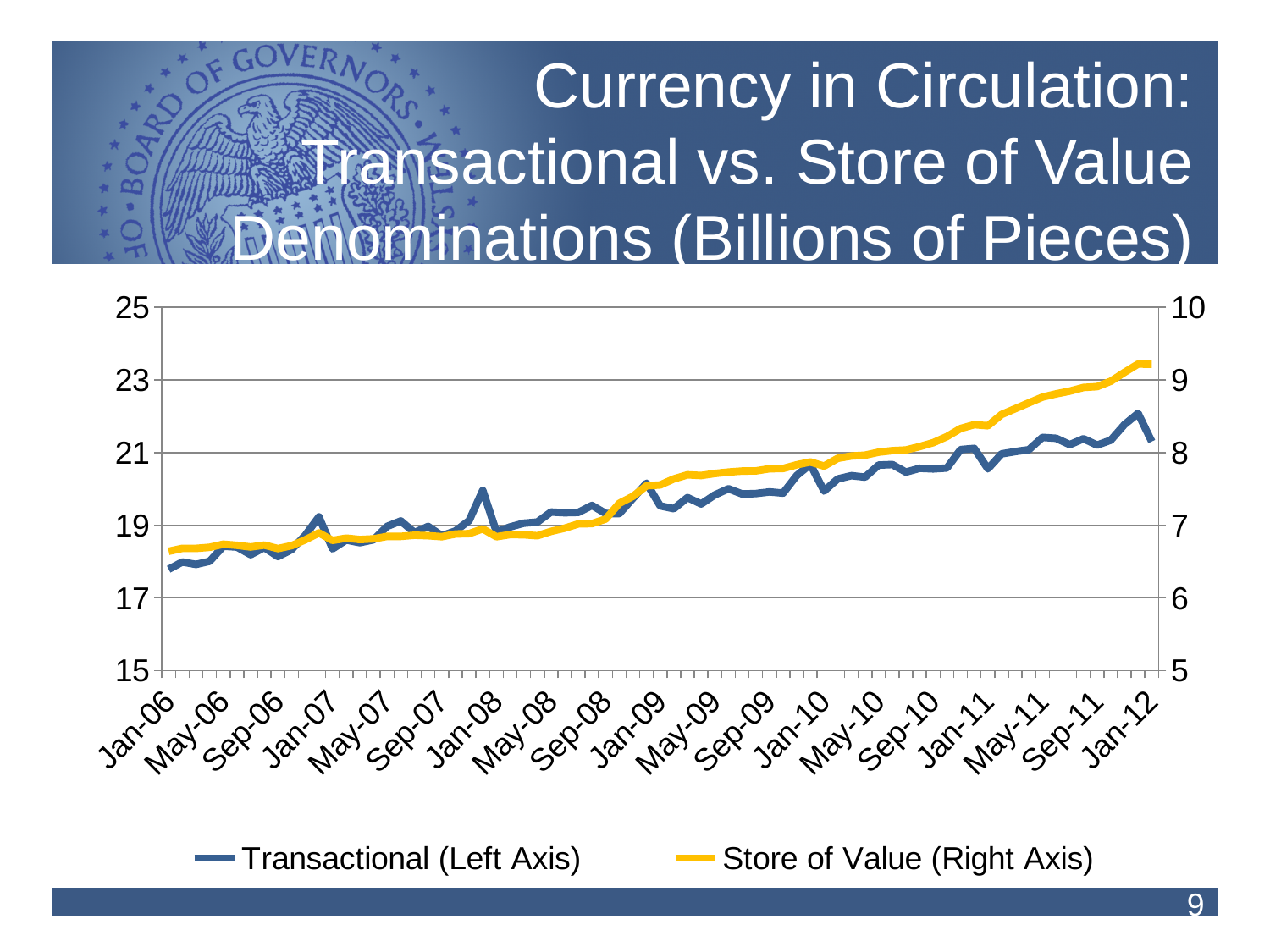
Does the Transactional line generally rise or fall from Jan-06 to Jan-12? rise What colour is the Transactional line? blue Is the Transactional value at Jan-06 greater or less than 19? less What kind of chart is shown on the slide? line chart Is the Store of Value value at Jan-06 greater or less than 7? less Does the Store of Value line rise or fall from Jan-06 to Jan-12? rise How many date labels are shown on the x axis? 19 Is the Store of Value value at Jan-12 greater or less than 9? greater Which series is plotted against the right axis? Store of Value How many series does the legend list? 2